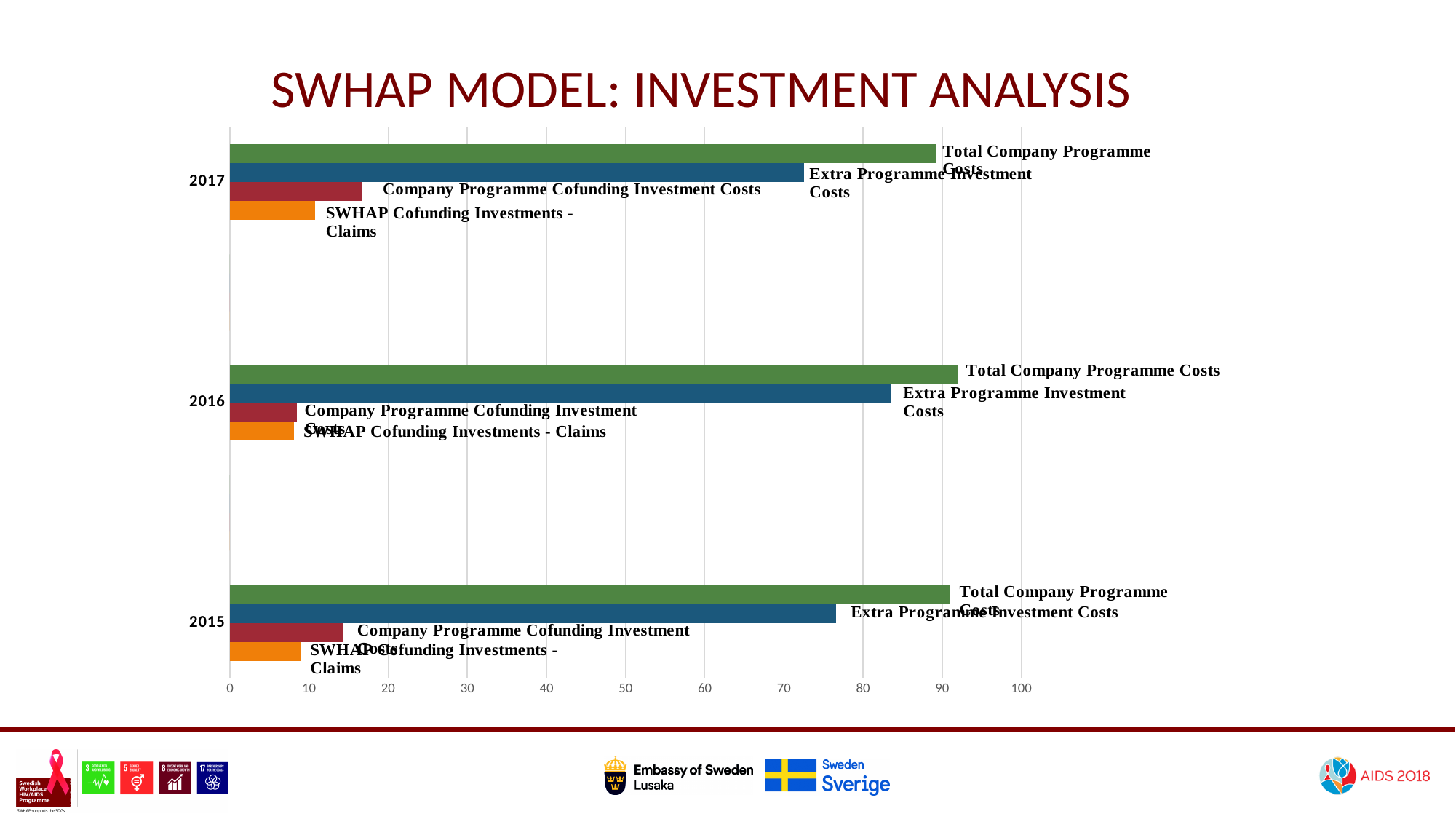
Is the value for SWHAP Cofunding Investments - Claims in 2017 greater or less than 20? less What is the title of the chart on the slide? SWHAP MODEL: INVESTMENT ANALYSIS How many years are shown on the chart's vertical axis? 3 Which year has the highest Extra Programme Investment Costs? 2016 Is the value for Extra Programme Investment Costs in 2016 greater or less than 80? greater Is the value for Total Company Programme Costs in 2017 greater or less than 80? greater Which is larger: Extra Programme Investment Costs in 2017 or in 2016? 2016 Which is larger: Company Programme Cofunding Investment Costs in 2017 or in 2016? 2017 How many bars are plotted for each year on the chart? 4 Which year has the lowest Company Programme Cofunding Investment Costs? 2016 What kind of chart is shown on the slide? bar chart